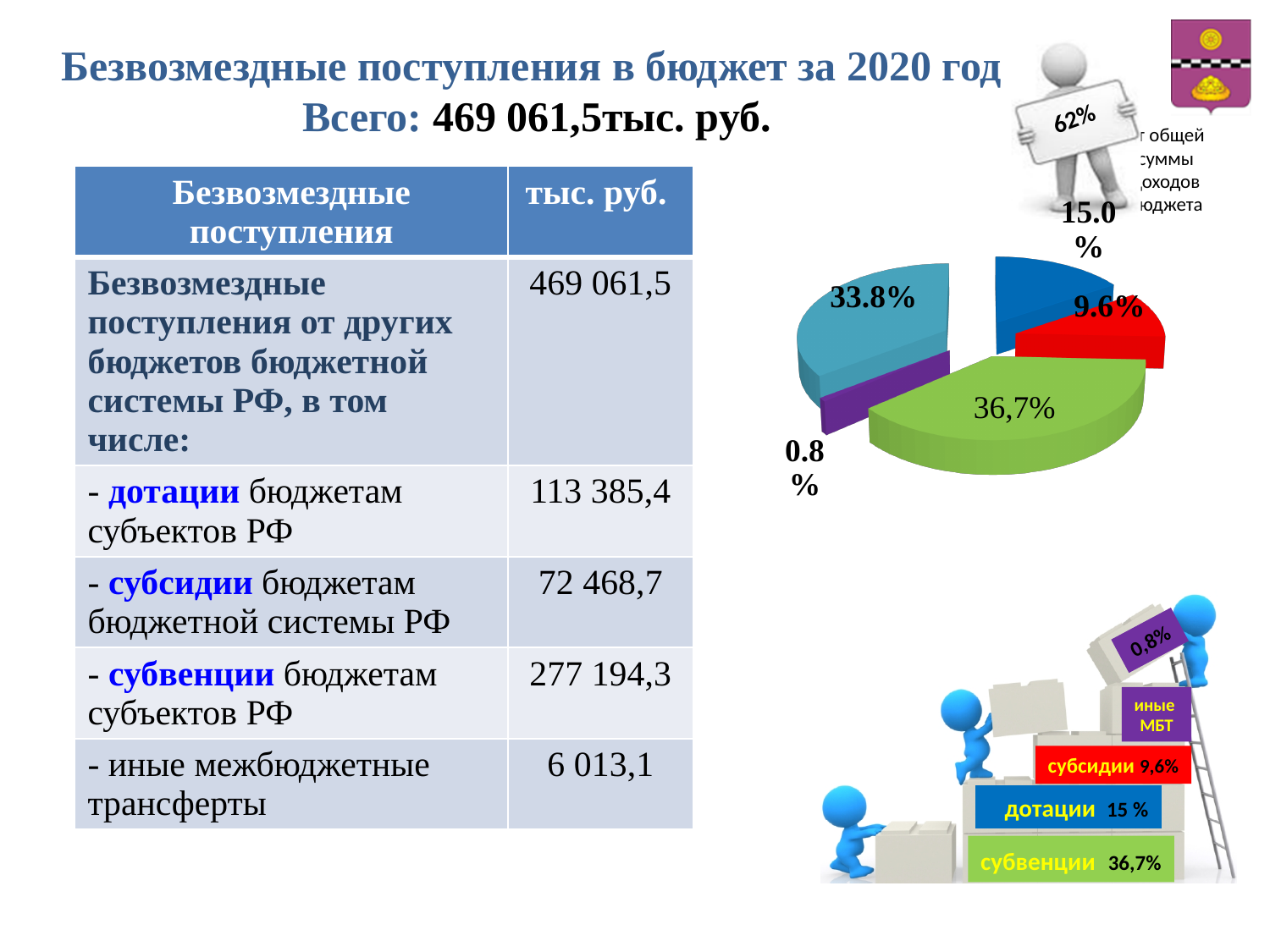
How many slices does the pie chart have? 5 What percentage is labelled on the green slice of the pie chart? 36,7% What is the largest percentage labelled on the pie chart? 36,7% Which slice of the pie chart is larger, the blue one at 15.0% or the red one at 9.6%? the blue one (15.0%) What percentage is labelled on the red slice of the pie chart? 9.6% What is the smallest percentage labelled on the pie chart? 0.8% What percentage is labelled on the teal (light blue) slice of the pie chart? 33.8% In the staircase graphic at the bottom right, what share is shown for дотации? 15 % In the staircase graphic at the bottom right, what share is shown for субвенции? 36,7% What percentage is labelled on the blue slice of the pie chart? 15.0% What is the difference in percentage points between the 15.0% slice and the 9.6% slice of the pie chart? 5.4 What kind of chart is shown on the slide? pie chart